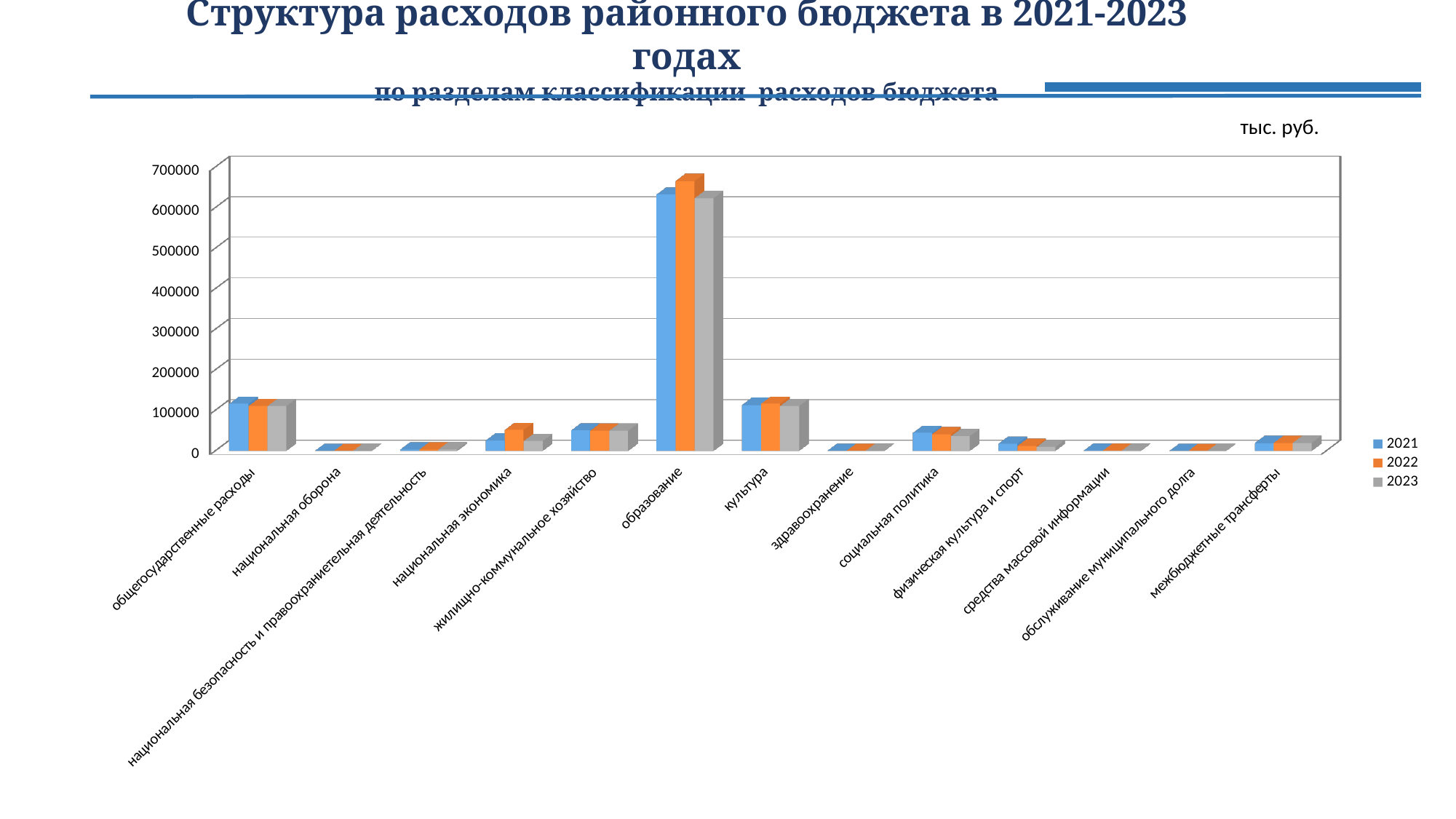
Which category has the highest expenditure in 2021? образование How many expenditure categories are shown along the x axis? 13 Is the 2021 value for общегосударственные расходы greater or less than 200000? less What kind of chart is shown on the slide? bar chart What unit of measurement is indicated above the chart? тыс. руб. Is the 2023 value for образование greater or less than 500000? greater Is the 2022 value for национальная экономика greater or less than 100000? less For национальная экономика, which year has the larger value: 2021 or 2022? 2022 How many series does the legend list? 3 Which category has the highest expenditure in 2022? образование Which is larger in 2022: образование or культура? образование